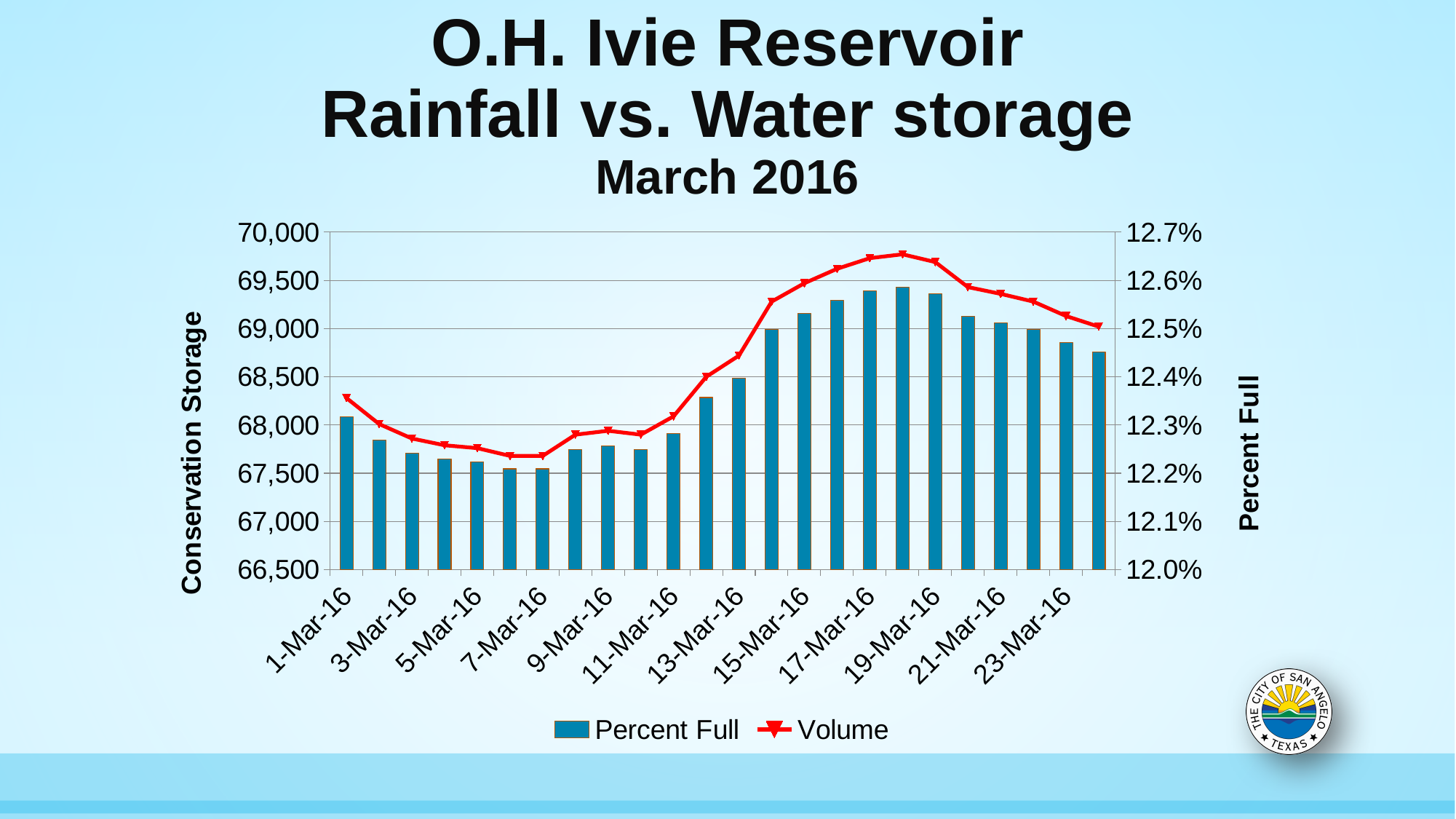
What is the title of the right-hand vertical axis? Percent Full Is the bar for 17-Mar-16 greater or less than 69,000? greater How many series does the legend list? 2 What are the two series named in the legend? Percent Full and Volume Is the Volume line value for 19-Mar-16 greater or less than 12.6%? greater What kind of chart is shown on the slide? A combined bar and line chart Is the bar for 7-Mar-16 greater or less than 68,000? less How many bars are plotted in the chart? 24 Which bar is taller, 1-Mar-16 or 17-Mar-16? 17-Mar-16 Do the bars rise or fall from 13-Mar-16 to 17-Mar-16? rise